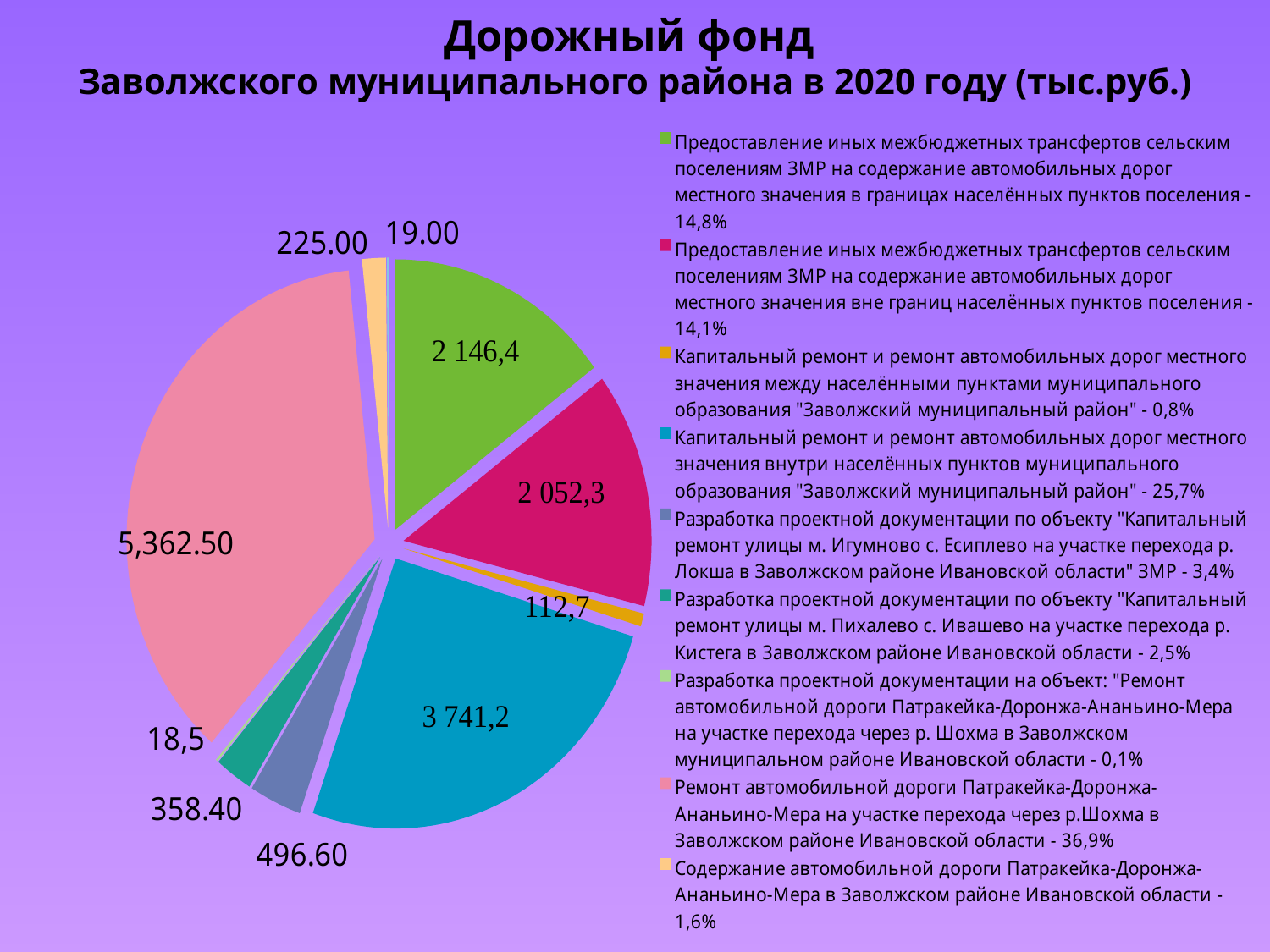
What is the smallest value shown on the pie chart? 18,5 How many slices does the pie chart have? 10 What is the difference between the values 2 146,4 and 2 052,3 shown on the pie chart? 94,1 According to the legend, what share of the pie does 'Капитальный ремонт и ремонт автомобильных дорог местного значения внутри населённых пунктов муниципального образования "Заволжский муниципальный район"' represent? 25,7% What value is shown for the slice 'Содержание автомобильной дороги Патракейка-Доронжа-Ананьино-Мера в Заволжском районе Ивановской области'? 225.00 What value is shown for the slice 'Предоставление иных межбюджетных трансфертов сельским поселениям ЗМР на содержание автомобильных дорог местного значения в границах населённых пунктов поселения'? 2 146,4 What is the largest value shown on the pie chart? 5,362.50 What value is shown for the slice 'Капитальный ремонт и ремонт автомобильных дорог местного значения внутри населённых пунктов муниципального образования "Заволжский муниципальный район"'? 3 741,2 According to the legend, what share of the pie does 'Ремонт автомобильной дороги Патракейка-Доронжа-Ананьино-Мера на участке перехода через р.Шохма в Заволжском районе Ивановской области' represent? 36,9% Which is larger: the slice labelled 496.60 or the slice labelled 358.40? 496.60 What kind of chart is shown on the slide? pie chart What is the title of the chart on the slide? Дорожный фонд Заволжского муниципального района в 2020 году (тыс.руб.)